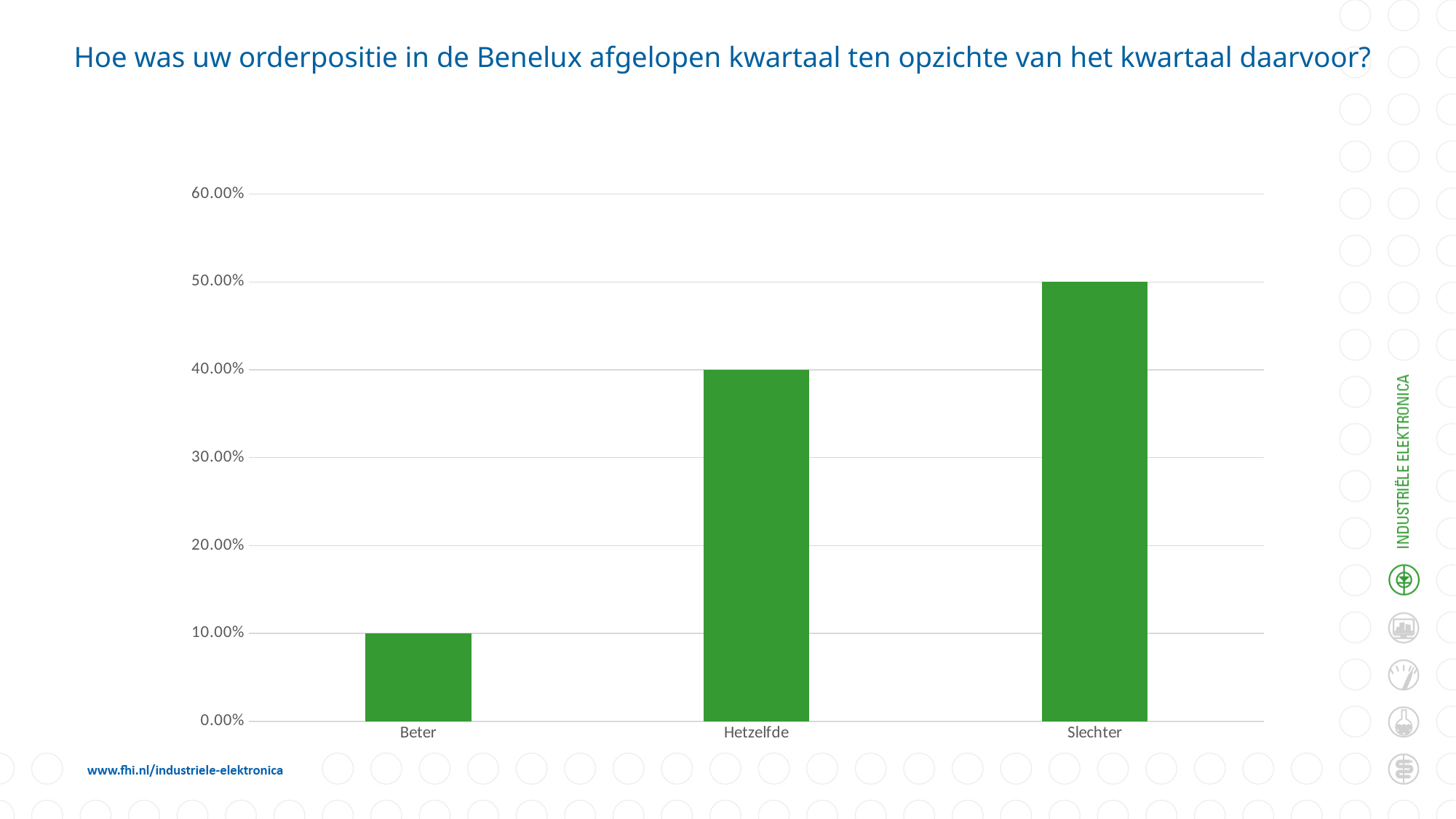
Which category has the highest value? Slechter What is the difference between the values for Slechter and Hetzelfde? 10.00% What is the value for Hetzelfde? 40.00% What is the value for Slechter? 50.00% What is the value for Beter? 10.00% What is the title of the chart? Hoe was uw orderpositie in de Benelux afgelopen kwartaal ten opzichte van het kwartaal daarvoor? Do the values rise or fall from left to right along the x axis? rise Which is larger, the value for Beter or the value for Hetzelfde? Hetzelfde What type of chart is shown on the slide? bar chart How many categories are shown on the x axis of the chart? 3 Which category has the lowest value? Beter What is the difference between the values for Hetzelfde and Beter? 30.00%